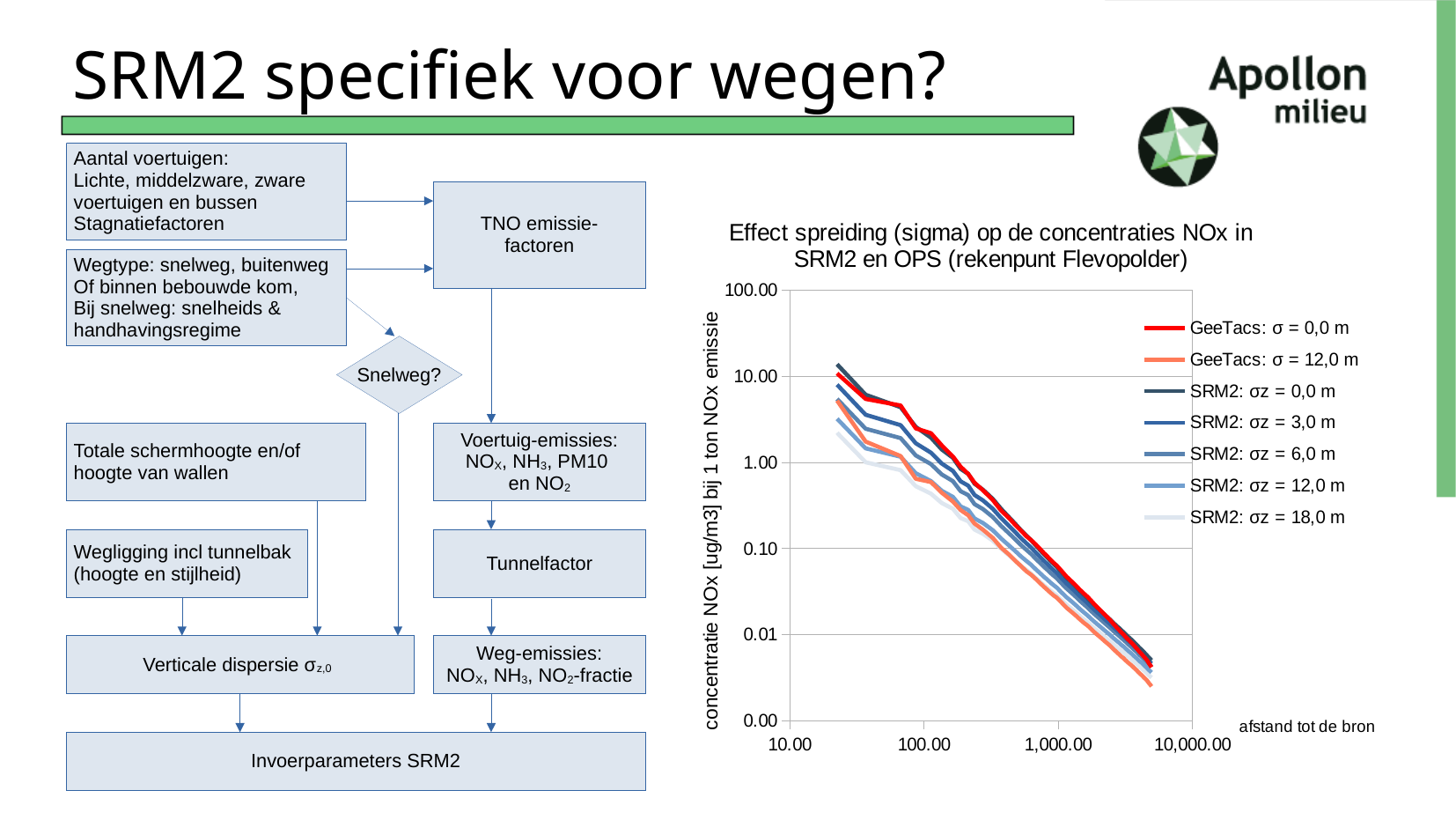
At the leftmost point of the chart, which series has the lowest concentration? SRM2: σz = 18,0 m Is the value for 'SRM2: σz = 0,0 m' at the leftmost point of the chart greater or less than 10.00? greater Is the value for 'SRM2: σz = 18,0 m' at the leftmost point of the chart greater or less than 10.00? less How many series does the legend of the chart list? 7 What kind of chart is shown on the slide? line chart What is the title of the chart? Effect spreiding (sigma) op de concentraties NOx in SRM2 en OPS (rekenpunt Flevopolder) At the leftmost point of the chart, which is larger: the value for 'SRM2: σz = 0,0 m' or the value for 'SRM2: σz = 18,0 m'? SRM2: σz = 0,0 m What is the label of the x axis of the chart? afstand tot de bron Is the value for 'GeeTacs: σ = 12,0 m' at the rightmost point of the chart greater or less than 0.01? less At the leftmost point of the chart, which series has the highest concentration? SRM2: σz = 0,0 m Do the values of the series 'GeeTacs: σ = 0,0 m' rise or fall as the distance to the source increases? fall